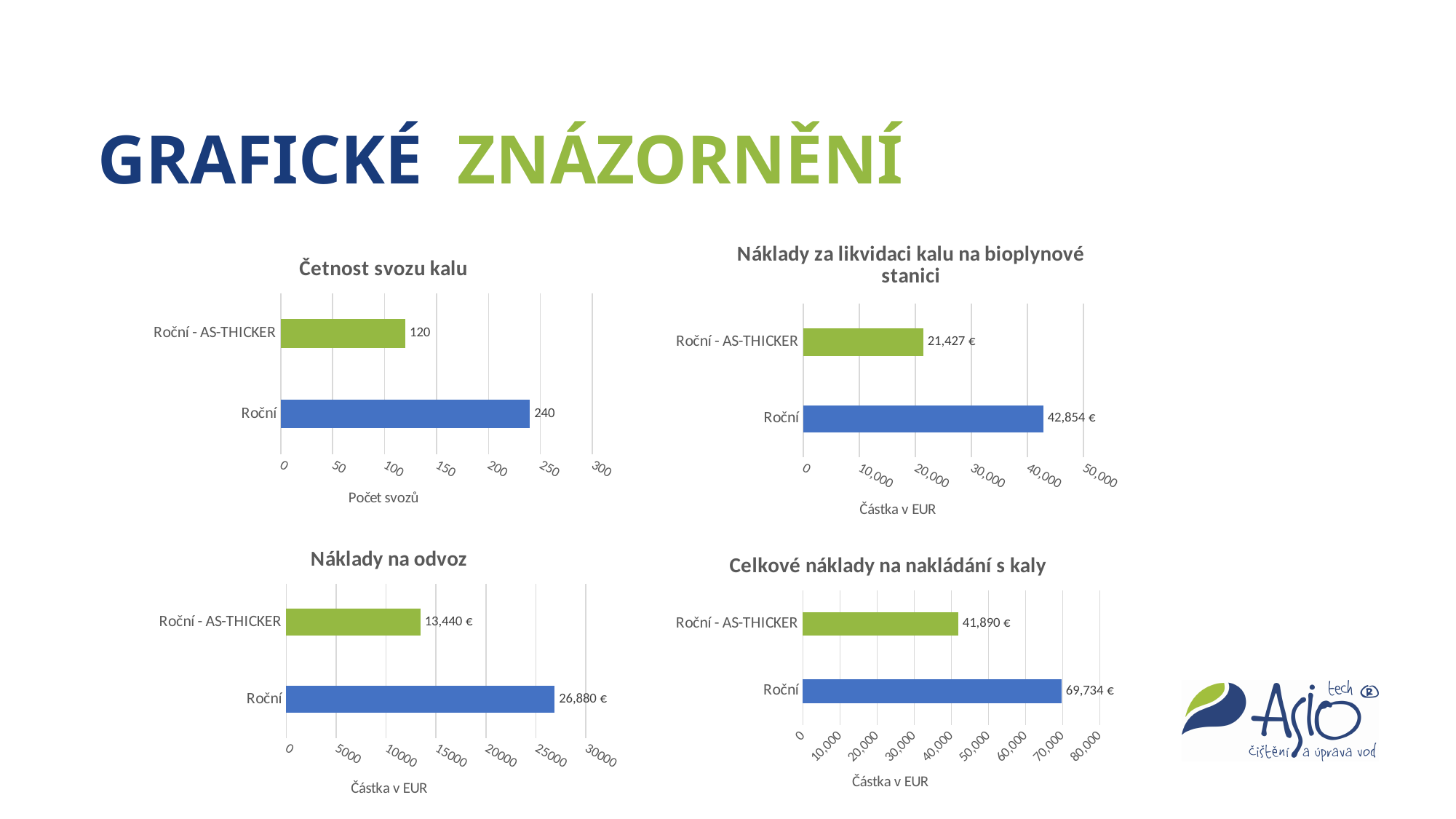
In the chart 'Četnost svozu kalu', what is the value for Roční? 240 In the chart 'Náklady za likvidaci kalu na bioplynové stanici', which category has the lowest value? Roční - AS-THICKER What kind of chart is 'Náklady na odvoz'? Bar chart In the chart 'Náklady za likvidaci kalu na bioplynové stanici', what is the value for Roční - AS-THICKER? 21,427 € In the chart 'Celkové náklady na nakládání s kaly', what is the difference between the Roční and Roční - AS-THICKER values? 27,844 € In the chart 'Náklady za likvidaci kalu na bioplynové stanici', what is the value for Roční? 42,854 € How many categories are shown in the chart 'Celkové náklady na nakládání s kaly'? 2 In the chart 'Náklady na odvoz', what is the value for Roční - AS-THICKER? 13,440 € In the chart 'Četnost svozu kalu', which category has the highest value? Roční In the chart 'Náklady na odvoz', what is the difference between the Roční and Roční - AS-THICKER values? 13,440 € In the chart 'Četnost svozu kalu', what is the value for Roční - AS-THICKER? 120 In the chart 'Celkové náklady na nakládání s kaly', what is the value for Roční? 69,734 €